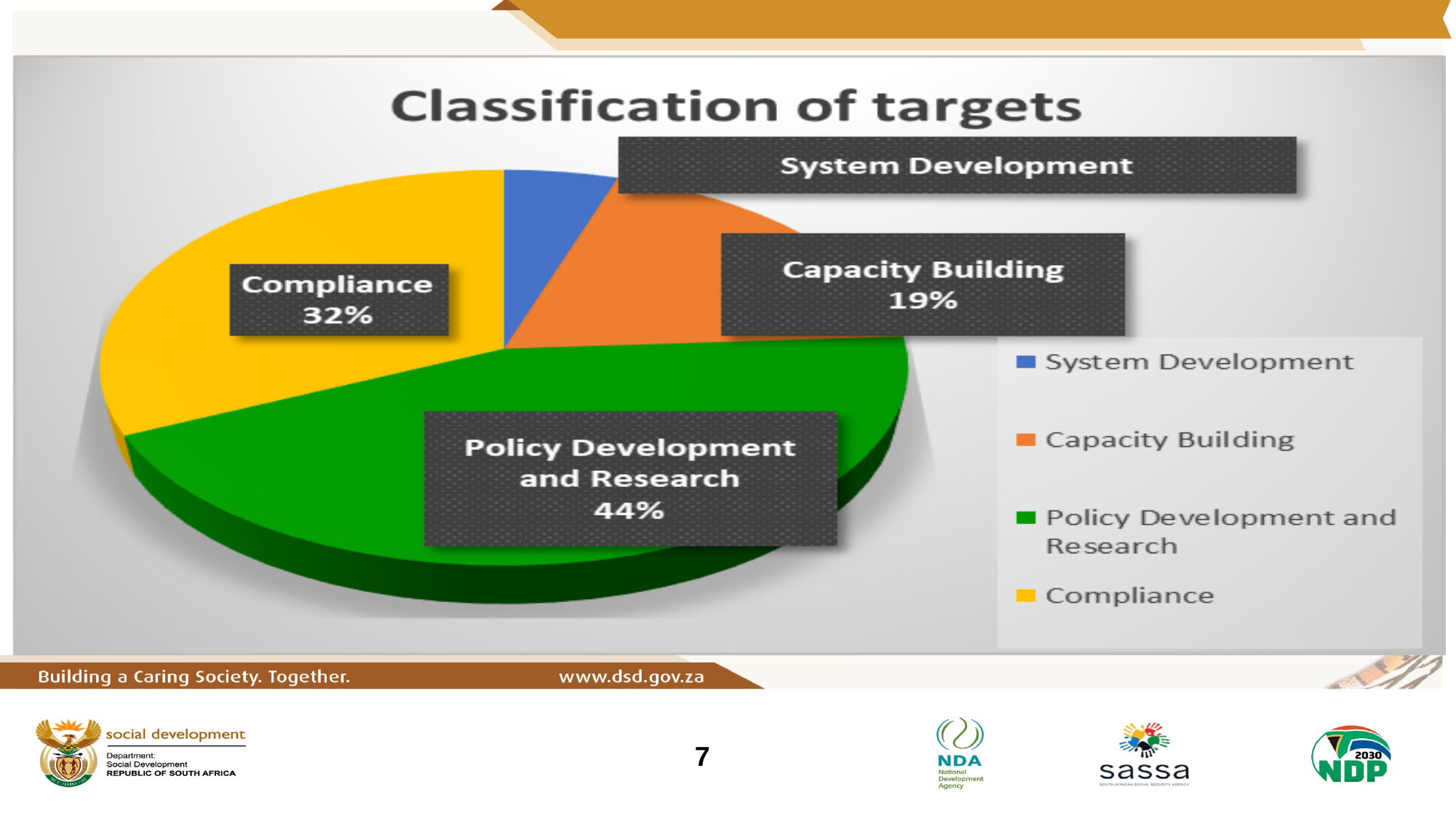
How many categories does the pie chart show? 4 What share of targets is classified as Capacity Building? 19% What share of targets is classified as Policy Development and Research? 44% Which classification has the largest share of targets? Policy Development and Research What is the title of the chart? Classification of targets Which is larger, the share for Compliance or the share for Capacity Building? Compliance What is the difference in percentage points between Policy Development and Research and Compliance? 12 What kind of chart is shown on the slide? pie chart Which colour represents Compliance in the pie chart? yellow How many entries does the legend list? 4 What share of targets is classified as Compliance? 32% Which classification has the smallest share of targets? System Development